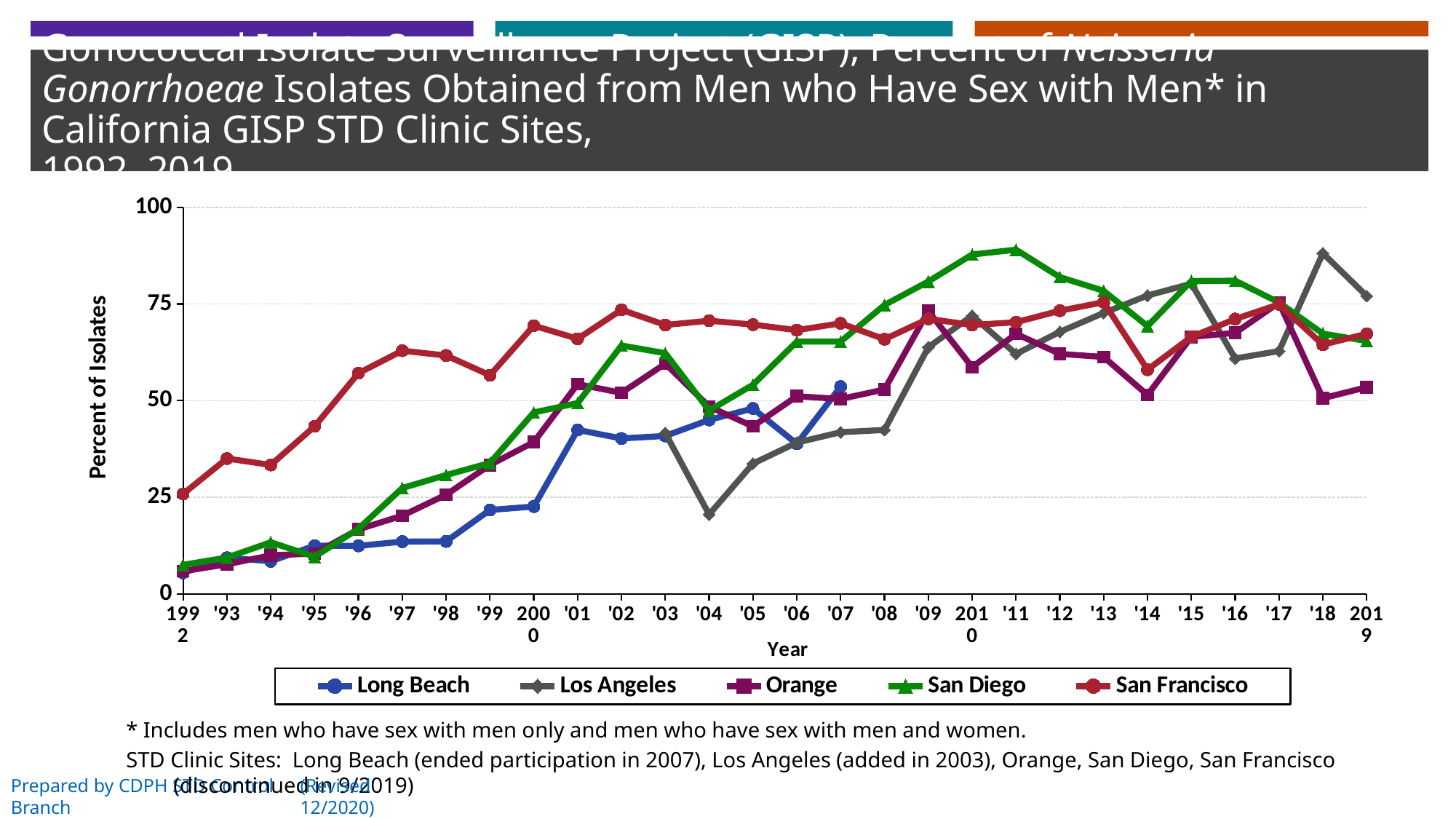
How many series does the legend list? 5 Which site has the highest percent of isolates in 1997? San Francisco How many years are shown along the x axis? 28 In 2000, which is larger: the value for San Francisco or the value for Long Beach? San Francisco Is the value for San Diego in 2011 greater or less than 75? greater Which site has the highest percent of isolates in 2018? Los Angeles Which site has the highest percent of isolates in 2011? San Diego Is the value for Los Angeles in 2004 greater or less than 25? less Is the value for Long Beach in 2001 greater or less than 50? less Does the Long Beach line generally rise or fall from 1992 to 2007? Rise What kind of chart is shown on the slide? Line chart Which site has the lowest percent of isolates in 2004? Los Angeles